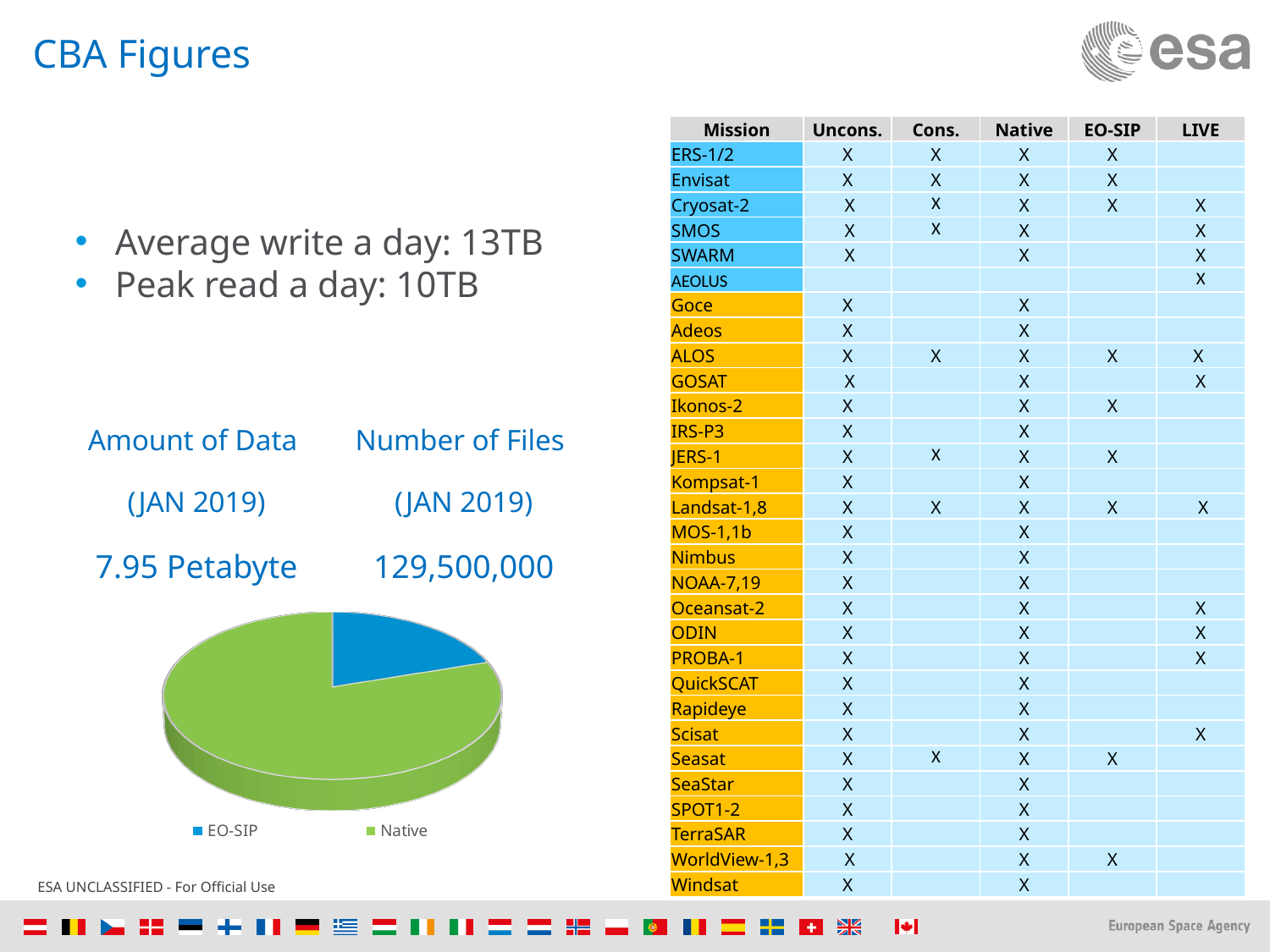
How many slices does the pie chart have? 2 Which slice of the pie chart is the largest? Native What colour is the EO-SIP slice in the pie chart? blue Which slice of the pie chart is the smallest? EO-SIP What colour is the Native slice in the pie chart? green In the pie chart, which is larger: the EO-SIP slice or the Native slice? Native What kind of chart is shown on the slide? pie chart How many entries does the pie chart's legend list? 2